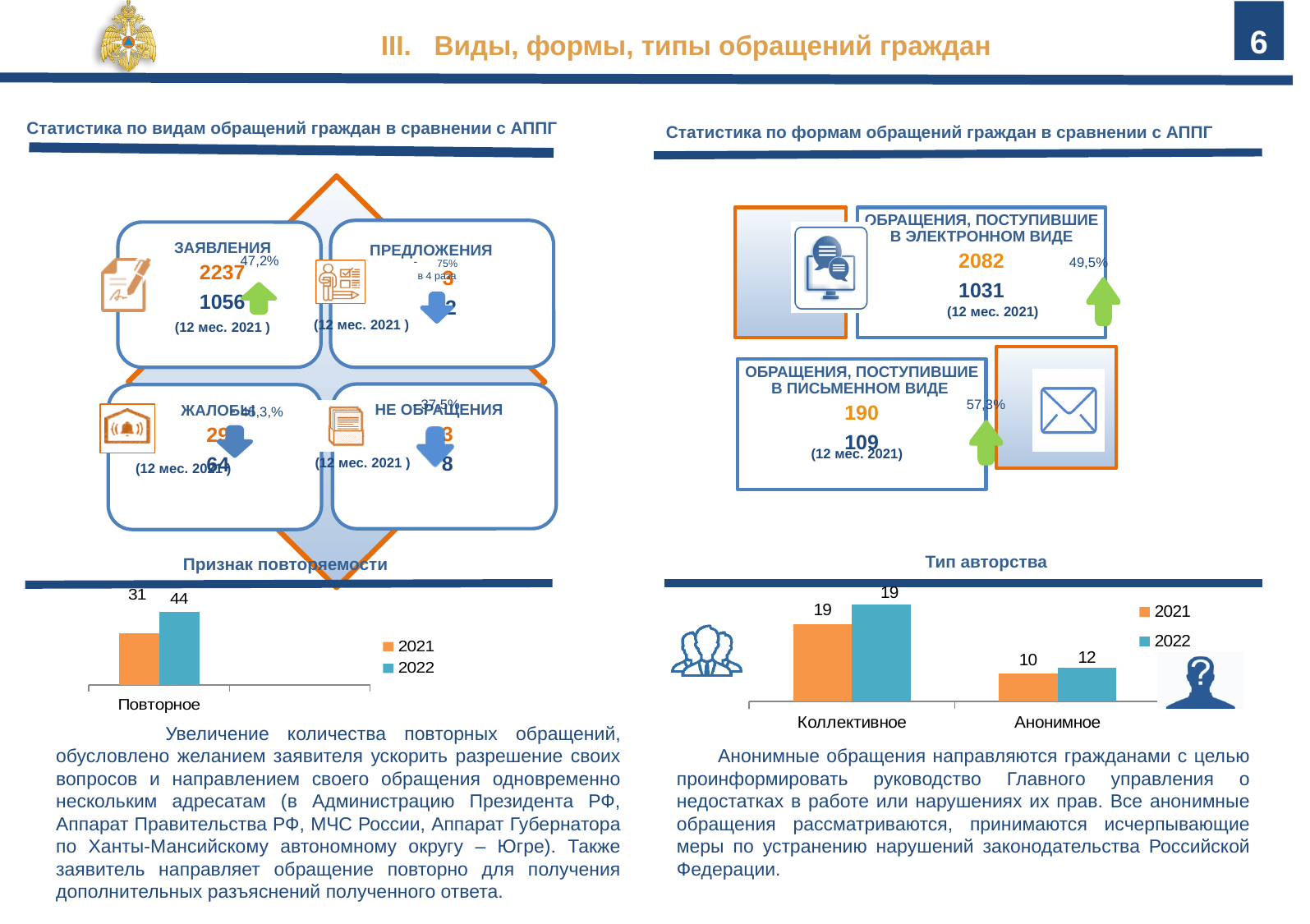
In the 'Тип авторства' chart, how many categories are shown on the x axis? 2 In the 'Признак повторяемости' chart, what is the value for 2021 for 'Повторное'? 31 In the 'Тип авторства' chart, which colour represents the 2021 series? orange In the 'Тип авторства' chart, which category has the higher 2022 value, 'Коллективное' or 'Анонимное'? Коллективное In the 'Тип авторства' chart, what is the value for 2022 for 'Анонимное'? 12 In the 'Тип авторства' chart, what is the difference between the 2022 and 2021 values for 'Анонимное'? 2 What kind of chart is the 'Признак повторяемости' chart? bar chart In the 'Признак повторяемости' chart, which series has the larger value for 'Повторное', 2021 or 2022? 2022 In the 'Признак повторяемости' chart, how many series does the legend list? 2 In the 'Признак повторяемости' chart, what is the value for 2022 for 'Повторное'? 44 In the 'Тип авторства' chart, what is the value for 2021 for 'Коллективное'? 19 In the 'Признак повторяемости' chart, what is the difference between the 2022 and 2021 values for 'Повторное'? 13